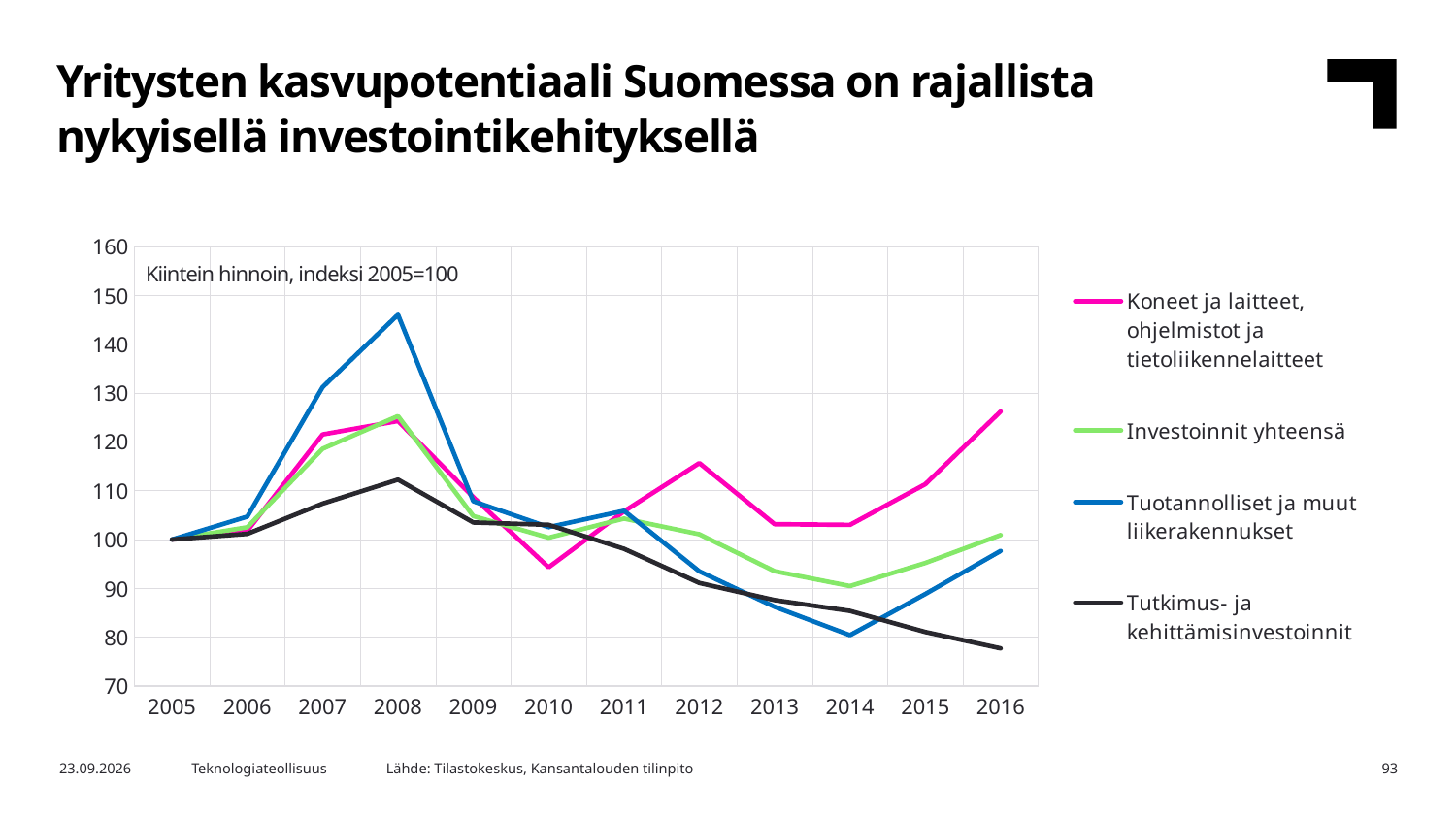
In 2012, which is larger: Koneet ja laitteet, ohjelmistot ja tietoliikennelaitteet or Tuotannolliset ja muut liikerakennukset? Koneet ja laitteet, ohjelmistot ja tietoliikennelaitteet Is the value for Tuotannolliset ja muut liikerakennukset in 2008 greater or less than 140? greater Which series has the lowest value in 2016? Tutkimus- ja kehittämisinvestoinnit How many series does the legend list? 4 In which year does Tuotannolliset ja muut liikerakennukset reach its highest value? 2008 What is the value of Investoinnit yhteensä in 2005? 100 How many years are shown on the x axis? 12 Is the value for Koneet ja laitteet, ohjelmistot ja tietoliikennelaitteet in 2010 greater or less than 100? less What note is printed inside the chart area about the index base? Kiintein hinnoin, indeksi 2005=100 Does Tutkimus- ja kehittämisinvestoinnit rise or fall from 2008 to 2016? Fall Which series has the highest value in 2008? Tuotannolliset ja muut liikerakennukset What kind of chart is shown on the slide? Line chart